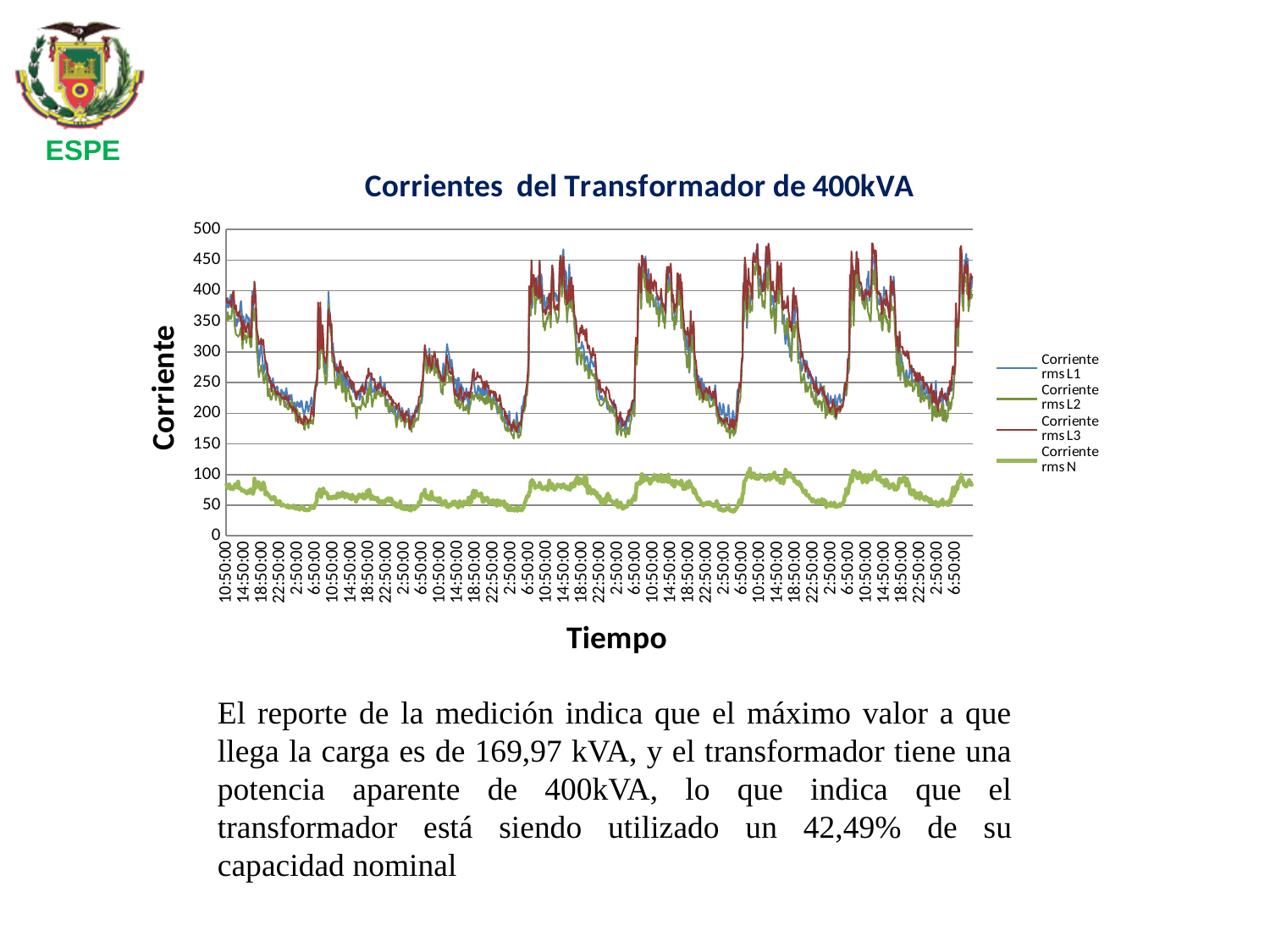
Is the peak value of the Corriente rms N series greater or less than 150? less Is the highest value reached by the Corriente rms L3 series greater or less than 400? greater What kind of chart is shown on the slide? Line chart How many series does the legend of the chart list? 4 What is the title of the chart? Corrientes del Transformador de 400kVA Which series has the lowest values throughout the chart: Corriente rms L1 or Corriente rms N? Corriente rms N Is the value of the Corriente rms N series ever greater or less than 150 across the whole chart? less What is the label of the vertical axis of the chart? Corriente What is the maximum value shown on the vertical axis of the chart? 500